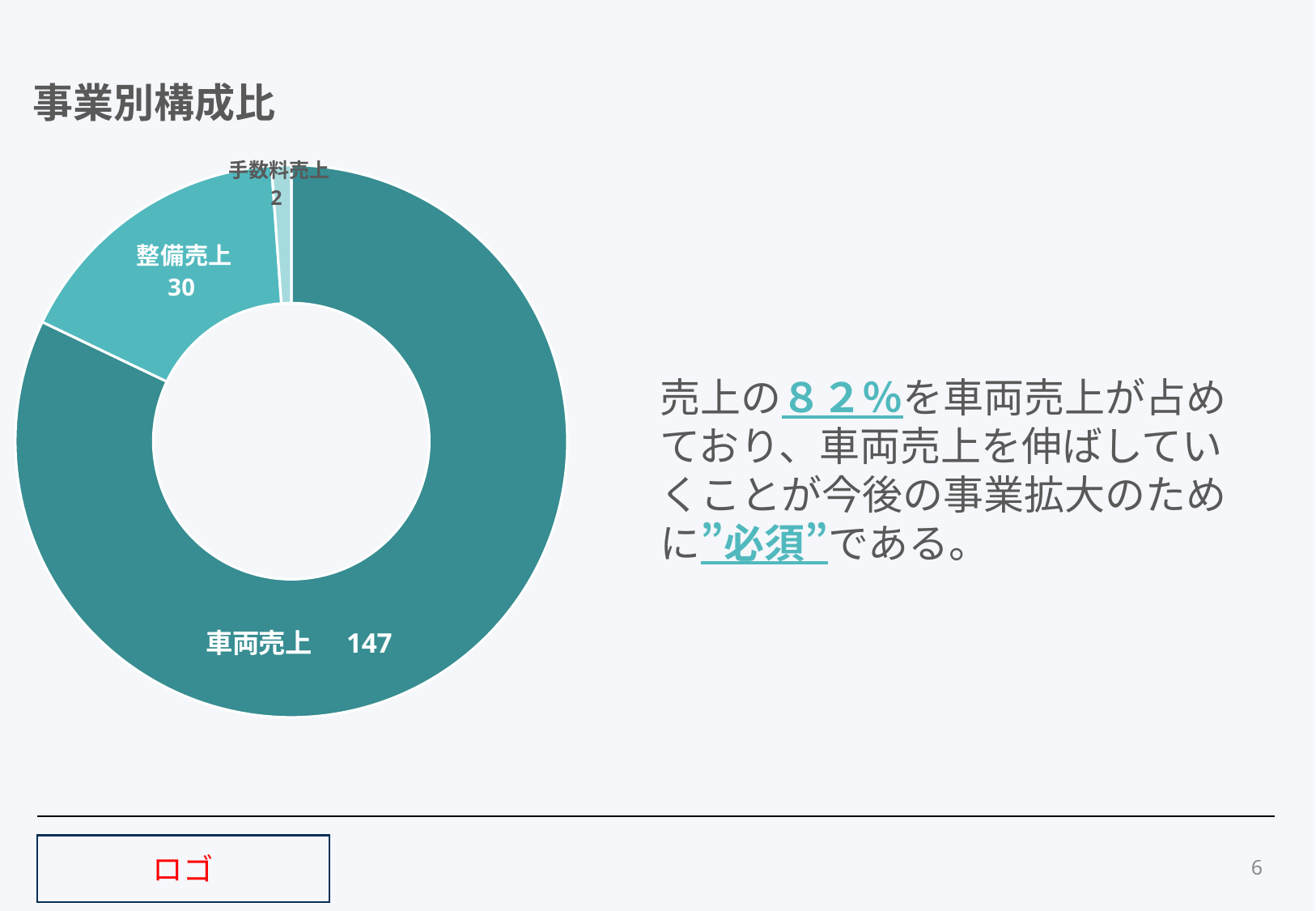
Which category has the largest value in the chart? 車両売上 How many categories are shown in the chart? 3 What is the total of all values shown in the chart? 179 What is the difference between the values for 車両売上 and 整備売上? 117 Which is larger, 整備売上 or 手数料売上? 整備売上 Which category has the smallest value in the chart? 手数料売上 What is the value for 車両売上 in the chart? 147 What is the difference between the values for 整備売上 and 手数料売上? 28 What is the value for 手数料売上 in the chart? 2 What is the value for 整備売上 in the chart? 30 What is the title of the chart on the slide? 事業別構成比 What kind of chart is shown on the slide? Doughnut chart